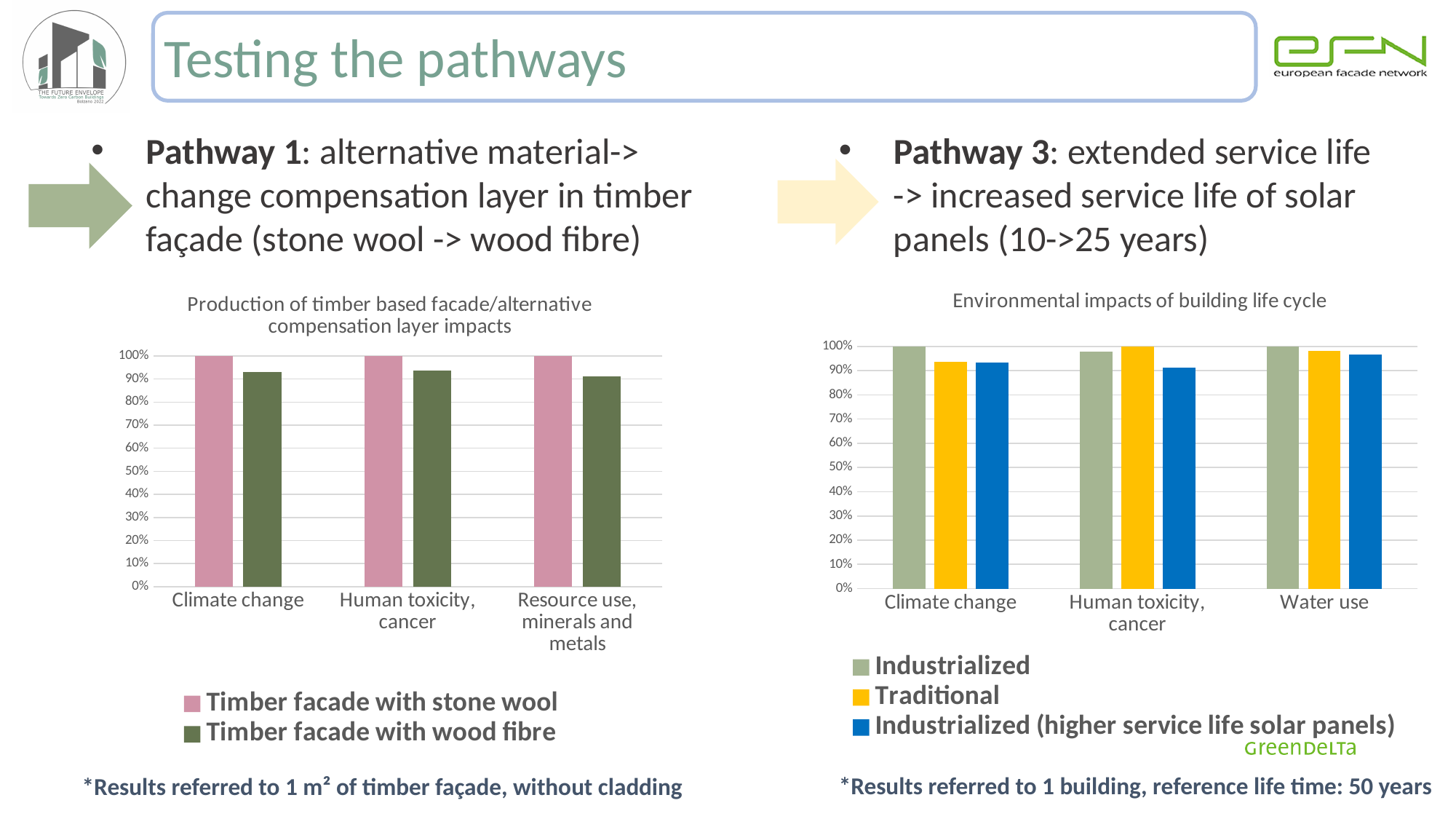
In the right chart 'Environmental impacts of building life cycle', is the value for 'Traditional' for Climate change greater or less than 90%? greater In the right chart 'Environmental impacts of building life cycle', what colour represents the 'Traditional' series? yellow In the left chart 'Production of timber based facade/alternative compensation layer impacts', what is the value for 'Timber facade with stone wool' for Climate change? 100% What kind of chart is the left chart titled 'Production of timber based facade/alternative compensation layer impacts'? bar chart How many categories are shown on the x axis of the left chart 'Production of timber based facade/alternative compensation layer impacts'? 3 In the left chart 'Production of timber based facade/alternative compensation layer impacts', is the value for 'Timber facade with wood fibre' for Climate change greater or less than 90%? greater In the left chart 'Production of timber based facade/alternative compensation layer impacts', which is larger for Human toxicity, cancer: 'Timber facade with stone wool' or 'Timber facade with wood fibre'? Timber facade with stone wool How many series does the legend of the right chart 'Environmental impacts of building life cycle' list? 3 In the right chart 'Environmental impacts of building life cycle', what is the value for 'Traditional' for Human toxicity, cancer? 100% How many series does the legend of the left chart 'Production of timber based facade/alternative compensation layer impacts' list? 2 In the right chart 'Environmental impacts of building life cycle', which series has the lowest value for Human toxicity, cancer? Industrialized (higher service life solar panels) How many categories are shown on the x axis of the right chart 'Environmental impacts of building life cycle'? 3